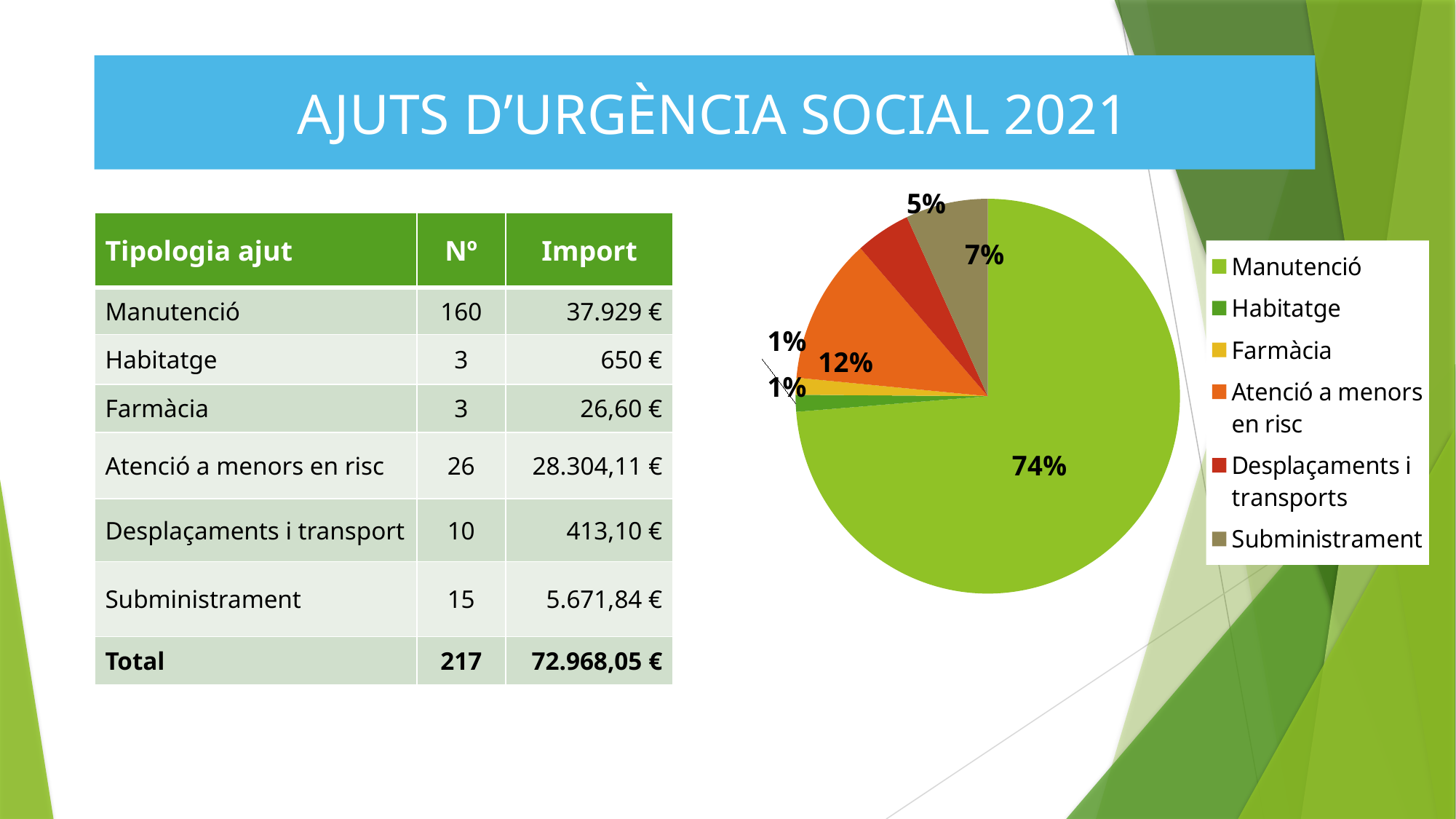
What share of the pie does Desplaçaments i transports represent? 5% Which slice is larger, Subministrament or Desplaçaments i transports? Subministrament What share of the pie does Atenció a menors en risc represent? 12% Which slice is larger, Atenció a menors en risc or Subministrament? Atenció a menors en risc Which category has the largest slice of the pie? Manutenció What is the difference in percentage points between the Manutenció slice and the Atenció a menors en risc slice? 62 percentage points What share of the pie does Manutenció represent? 74% How many categories does the legend of the pie chart list? 6 What kind of chart is shown on the slide? pie chart What colour is the Manutenció slice in the pie chart? light green